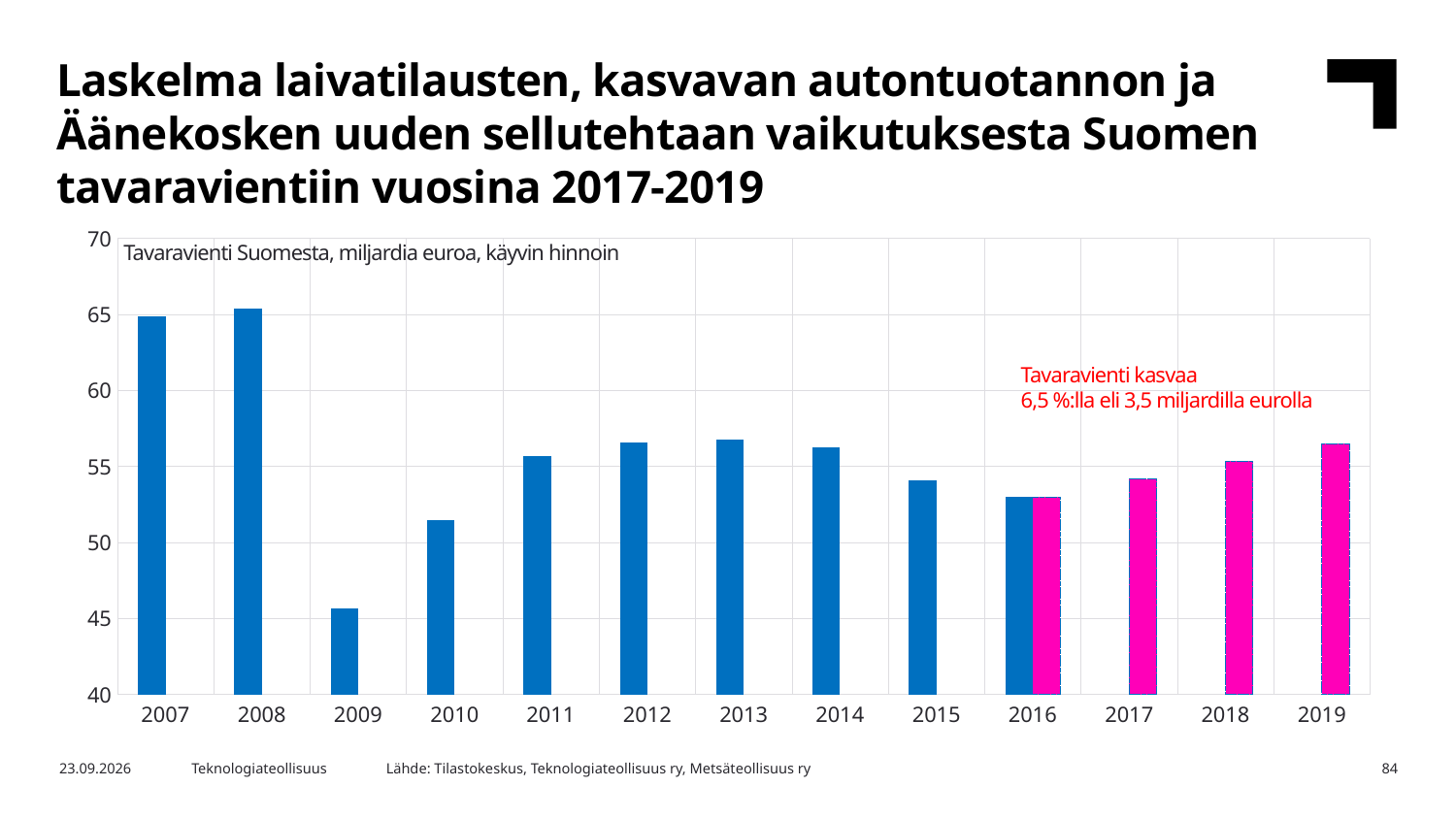
What does the text inside the chart area say the chart measures? Tavaravienti Suomesta, miljardia euroa, käyvin hinnoin Is the value for 2017 greater or less than 55? less Is the value for 2015 greater or less than 55? less Is the value for 2009 greater or less than 50? less Do the values rise or fall from 2016 to 2019? rise How many years are shown on the x axis of the chart? 13 What kind of chart is shown on the slide? bar chart Which year has the lowest value in the chart? 2009 According to the red annotation on the chart, by how many billion euros does goods export grow? 3,5 miljardilla eurolla Which is larger, the value for 2009 or the value for 2010? 2010